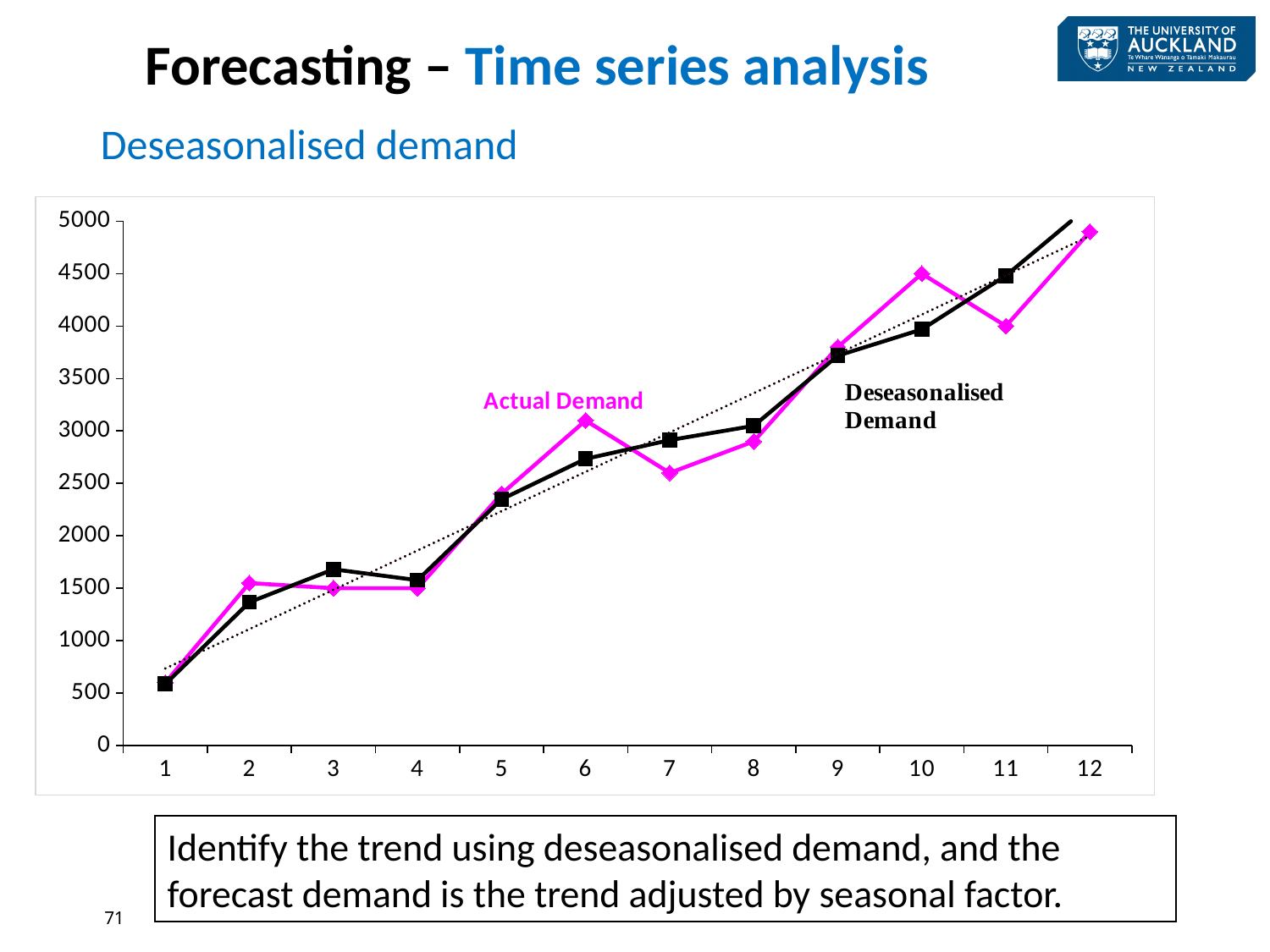
At period 6, which is higher: Actual Demand or Deseasonalised Demand? Actual Demand Is the Deseasonalised Demand value at period 12 greater or less than 4500? greater What kind of chart is shown on the slide? line chart What is the heading shown above the chart? Deseasonalised demand Is the Actual Demand value at period 11 greater or less than 4500? less Is the Actual Demand value at period 6 greater or less than 2500? greater Do the Deseasonalised Demand values generally rise or fall from period 1 to period 12? rise At period 7, which is higher: Actual Demand or Deseasonalised Demand? Deseasonalised Demand How many periods are shown along the x axis of the chart? 12 What colour is the Actual Demand line in the chart? magenta In which period is Actual Demand at its highest? 12